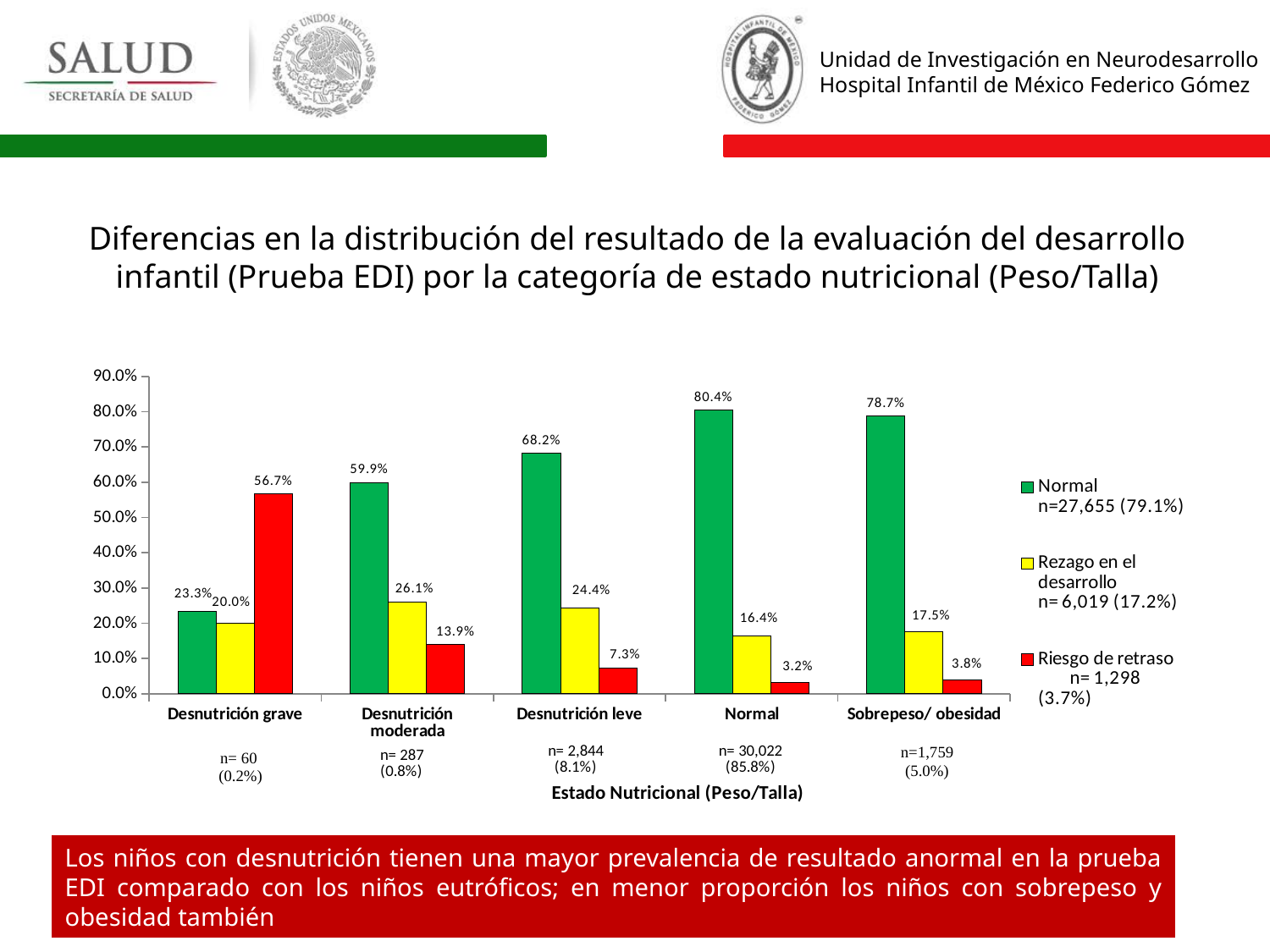
What is the value of the Normal series for the Desnutrición grave category? 23.3% What is the value of the Rezago en el desarrollo series for the Desnutrición moderada category? 26.1% Does the Normal series rise or fall from Desnutrición grave to Normal along the x axis? Rise What is the difference between the Normal series values for the Normal category and the Desnutrición leve category? 12.2% What is the value of the Normal series for the Sobrepeso/ obesidad category? 78.7% Which category has the highest value for the Normal series? Normal How many categories are shown on the x axis? 5 How many series does the legend list? 3 What type of chart is shown on the slide? Bar chart What is the value of the Riesgo de retraso series for the Desnutrición grave category? 56.7% Which is larger: the Riesgo de retraso value for Desnutrición moderada or for Desnutrición leve? Desnutrición moderada Which category has the lowest value for the Riesgo de retraso series? Normal